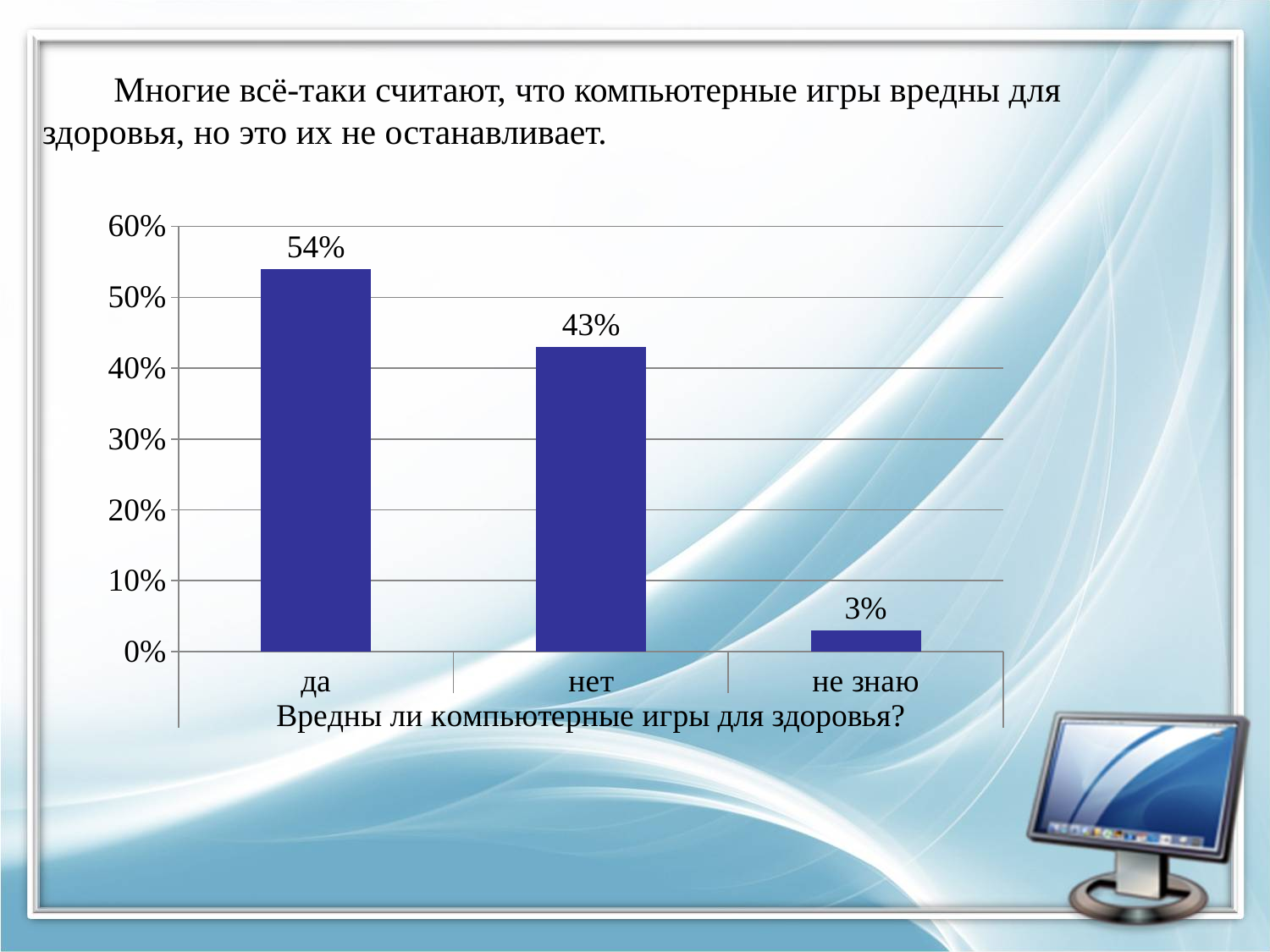
How many categories are shown on the x axis? 3 Which category has the lowest value? не знаю Is the value for "нет" greater or less than 40%? greater Which category has the highest value? да Which is larger, the value for "да" or the value for "нет"? да What is the value for "да"? 54% What is the difference between the values for "нет" and "не знаю"? 40% What is the difference between the values for "да" and "нет"? 11% What is the value for "не знаю"? 3% What kind of chart is shown on the slide? bar chart What is the value for "нет"? 43% What is the label shown under the x axis of the chart? Вредны ли компьютерные игры для здоровья?